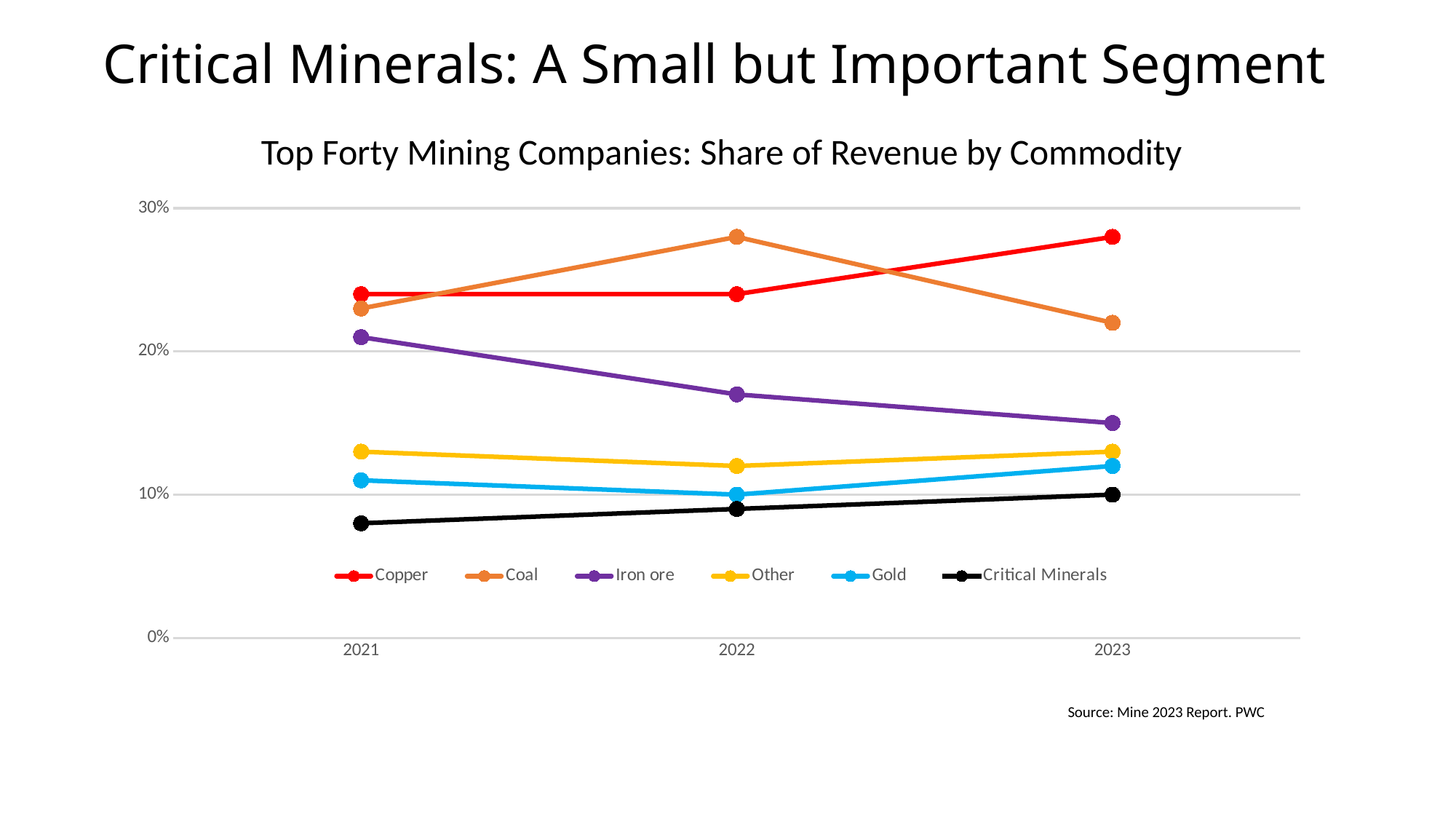
What is the title of the chart? Top Forty Mining Companies: Share of Revenue by Commodity In 2023, which is larger: the share for Copper or the share for Coal? Copper Which commodity has the highest share of revenue in 2023? Copper Is the value for Iron ore in 2021 greater or less than 20%? greater Which commodity has the highest share of revenue in 2022? Coal Is the value for Critical Minerals in 2021 greater or less than 10%? less How many series does the legend list? 6 Which commodity has the lowest share of revenue in 2021? Critical Minerals What kind of chart is shown on the slide? Line chart Is the value for Coal in 2023 greater or less than 20%? greater Does the share of revenue for Iron ore rise or fall from 2021 to 2023? Fall How many years are shown on the x axis? 3